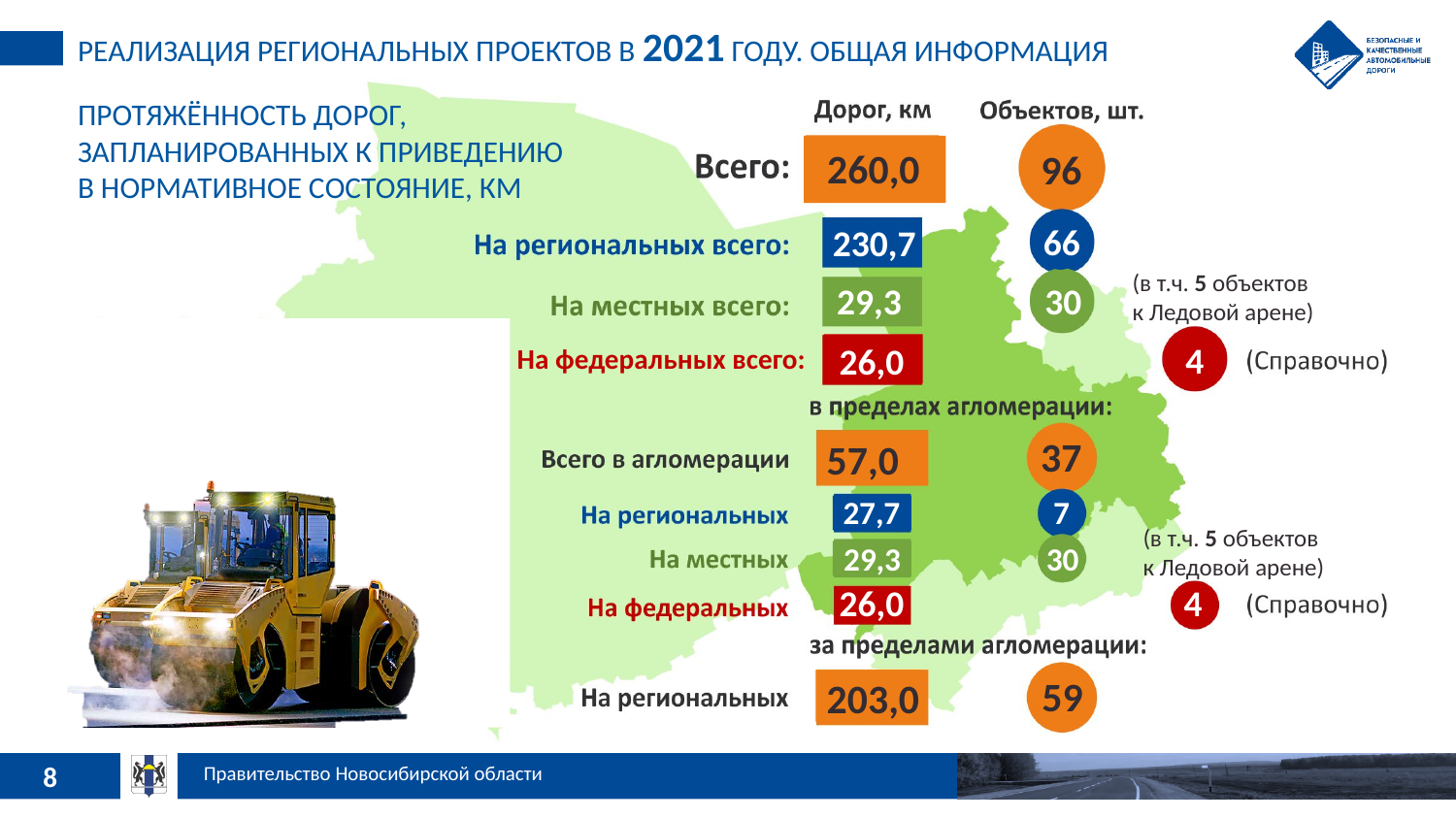
How many objects are listed for 'На местных всего'? 30 What is the road length value for 'На региональных всего'? 230,7 What is the difference between the total number of objects (96) and the number of objects in the agglomeration (37)? 59 How many objects are shown for 'На региональных' за пределами агломерации? 59 Which has more objects: 'На региональных' в пределах агломерации or 'На местных' в пределах агломерации? На местных How many objects (Объектов, шт.) are shown for 'Всего'? 96 What is the road length for 'Всего в агломерации'? 57,0 Among regional, local and federal roads in the 'всего' group, which has the greatest road length? На региональных всего What is the total length of roads (Дорог, км) shown for 'Всего'? 260,0 Among regional, local and federal roads in the 'всего' group, which has the smallest number of objects? На федеральных всего What are the two column headings above the values on the slide? Дорог, км and Объектов, шт. What is the difference in road length between 'На региональных всего' (230,7) and 'На региональных' в пределах агломерации (27,7)? 203,0